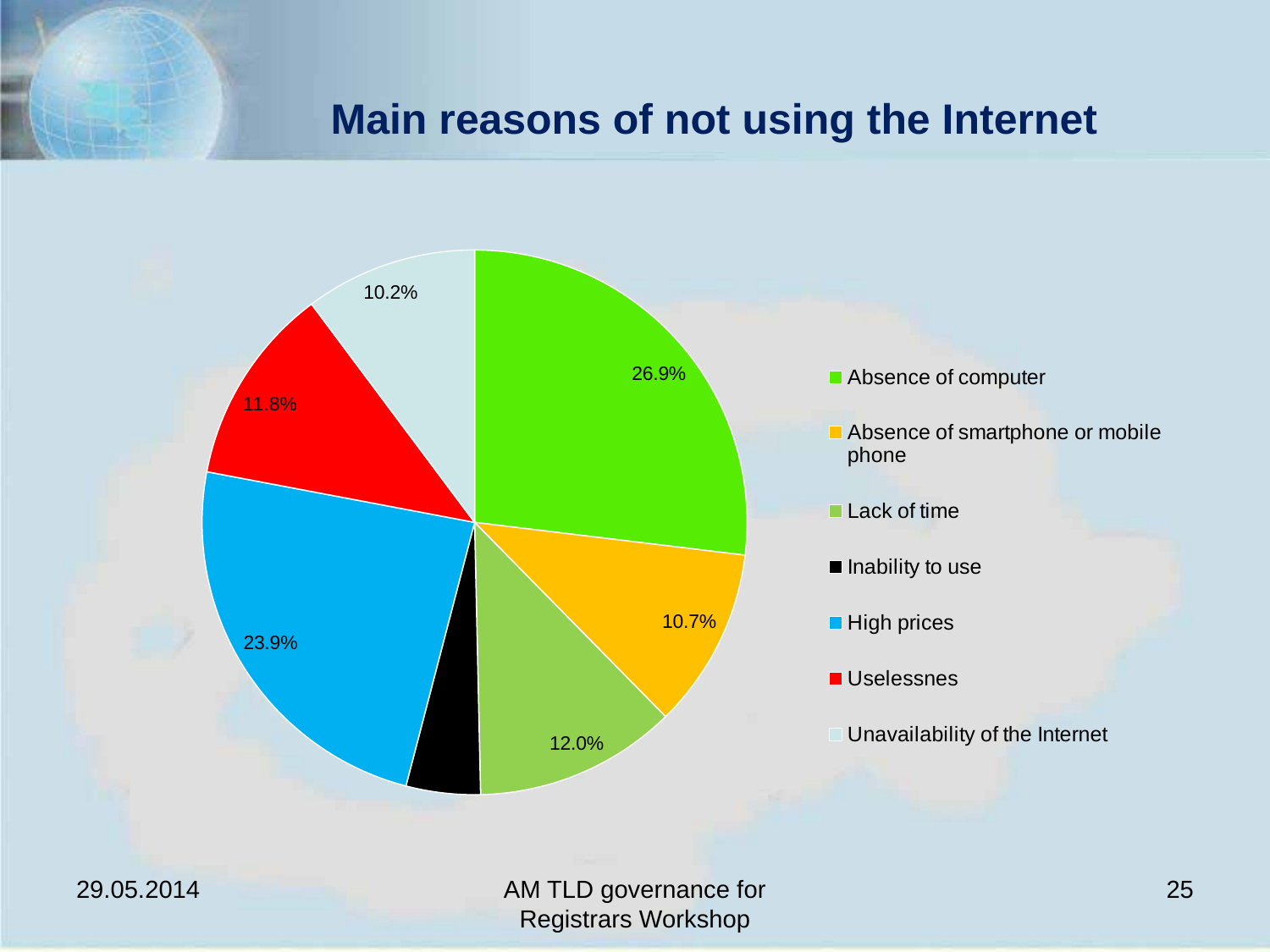
Which reason has the smallest slice of the pie? Inability to use What type of chart is shown on the slide? Pie chart What share of the pie is labelled for Absence of computer? 26.9% How many categories does the pie chart show? 7 What percentage is shown for Uselessnes? 11.8% What is the title of the chart on the slide? Main reasons of not using the Internet Which is larger, the share for Lack of time or the share for Absence of smartphone or mobile phone? Lack of time What is the difference between the shares for Absence of computer and High prices? 3.0% What share is labelled for Unavailability of the Internet? 10.2% Which reason has the largest slice of the pie? Absence of computer What value is printed for Lack of time? 12.0% What percentage is shown for High prices? 23.9%